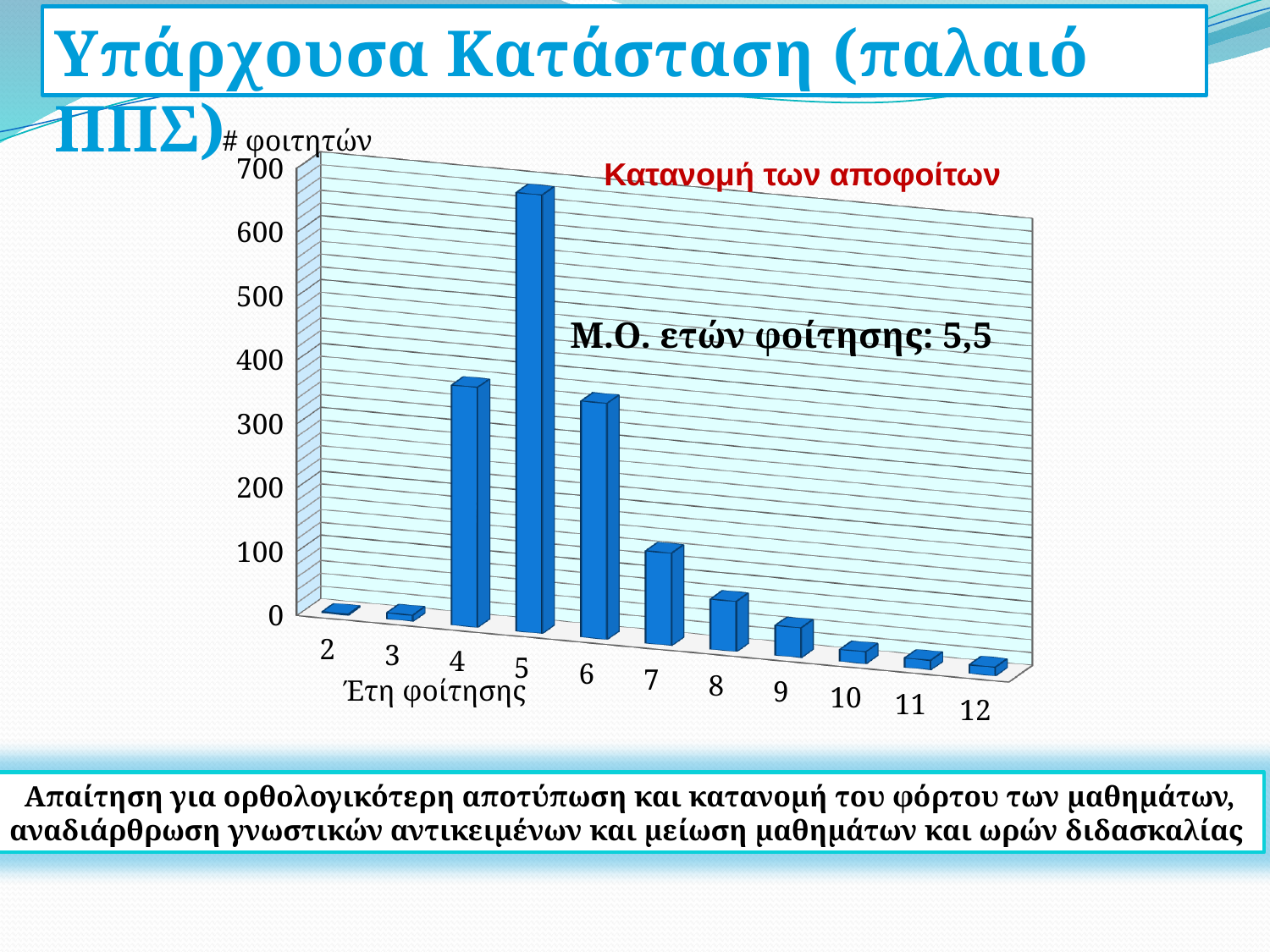
Is the value for year 4 greater or less than 300? greater Is the value for year 8 greater or less than 100? less Is the value for year 5 greater or less than 600? greater Do the values rise or fall from year 5 to year 12? fall How many categories (years of study) are shown on the x axis? 11 What average number of years of study is stated on the chart? 5,5 What is the title of the chart? Κατανομή των αποφοίτων Which has more students, year 5 or year 4? 5 Which year of study has the highest number of students? 5 What kind of chart is shown on the slide? bar chart